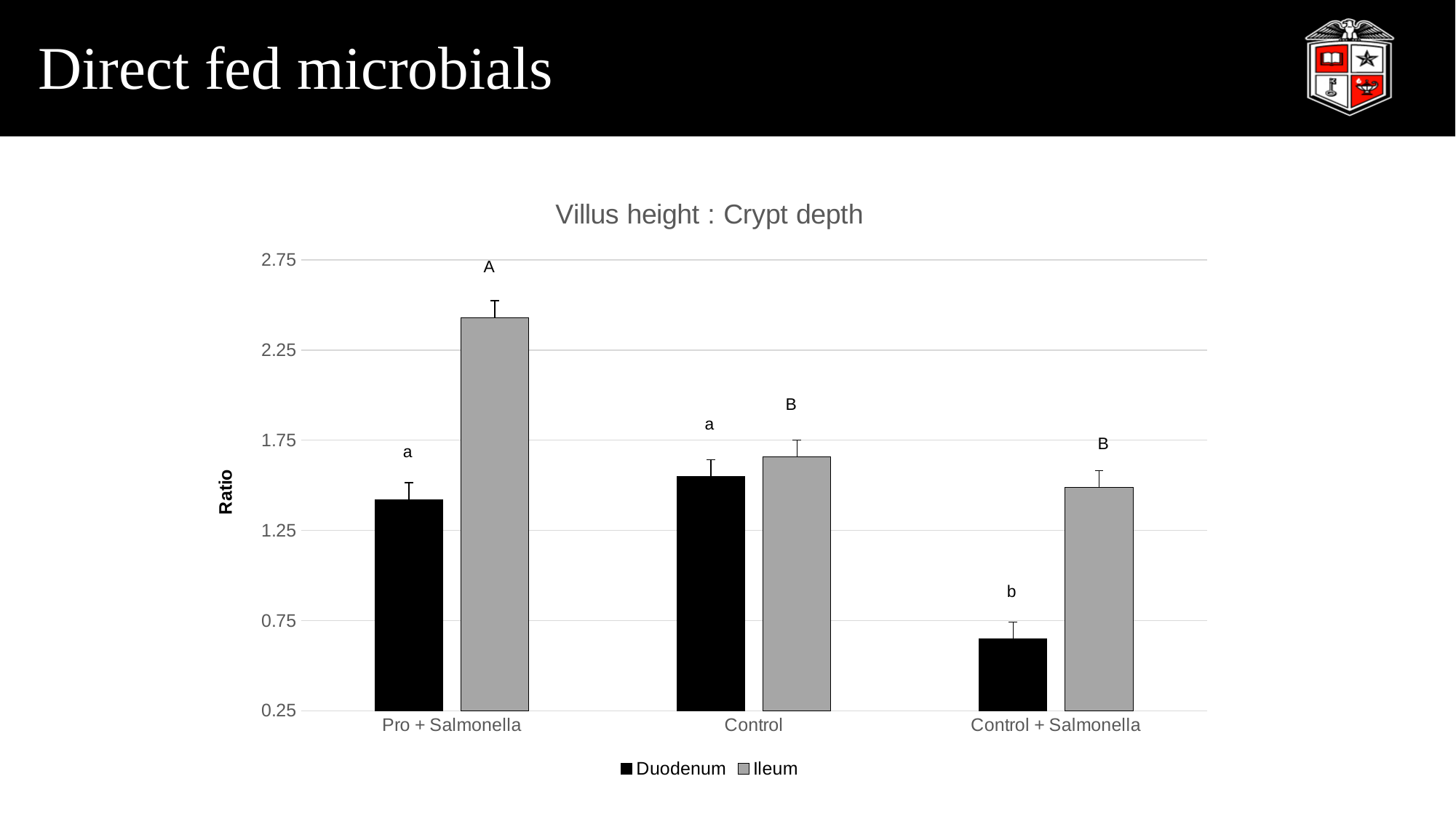
What is the title of the chart? Villus height : Crypt depth How many treatment categories are shown on the x axis? 3 What is the label of the y axis? Ratio How many series does the legend list? 2 For Control + Salmonella, which is larger, the Duodenum or the Ileum value? Ileum Is the Ileum value for Pro + Salmonella greater or less than 2.25? greater What type of chart is shown on the slide? bar chart Is the Ileum value for Control greater or less than 1.75? less Is the Duodenum value for Control + Salmonella greater or less than 0.75? less Which category has the highest Ileum value? Pro + Salmonella Which category has the lowest Duodenum value? Control + Salmonella